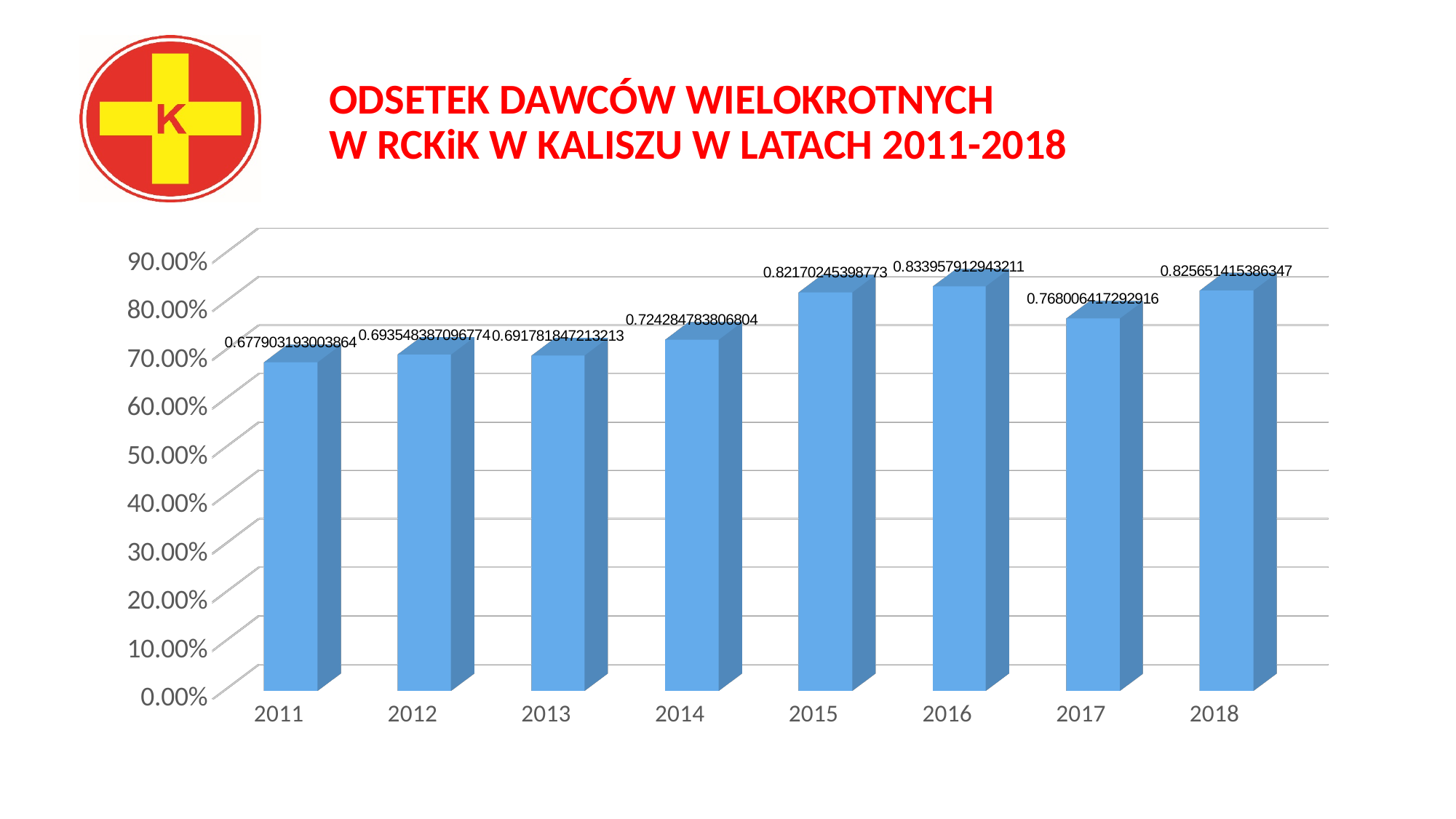
Which year has the lowest value? 2011 How many years are shown on the x axis? 8 What kind of chart is shown on the slide? bar chart What is the data label value for 2011? 0.677903193003864 What is the data label value for 2014? 0.724284783806804 Which year has the larger value, 2015 or 2017? 2015 Which year has the highest value? 2016 What is the data label value for 2016? 0.833957912943211 Do the values rise or fall from 2011 to 2016? rise What is the data label value for 2018? 0.825651415386347 Is the value for 2017 greater or less than 70.00%? greater Is the value for 2014 greater or less than 80.00%? less